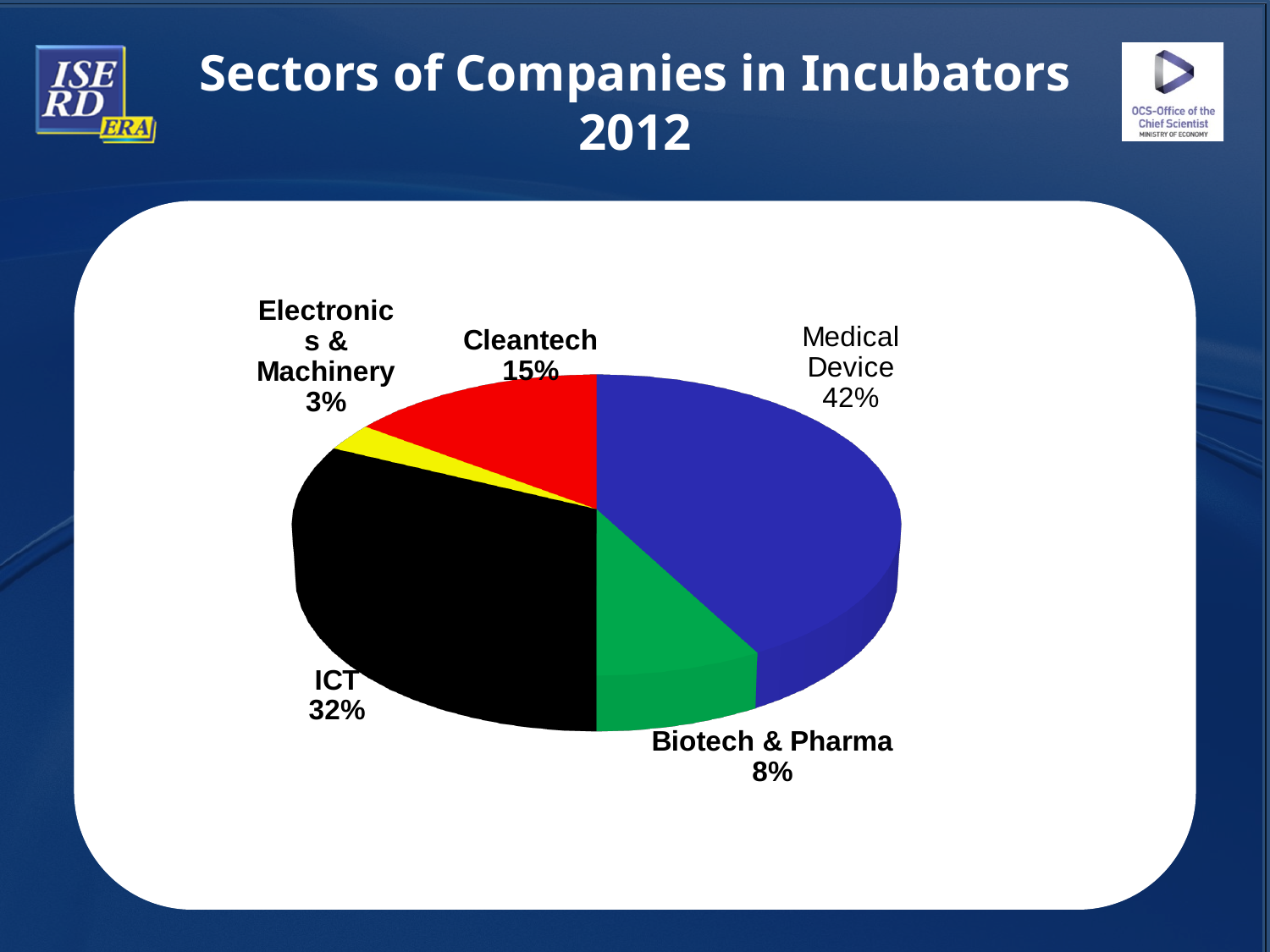
What share of companies in incubators is in the Medical Device sector? 42% How many sectors are shown in the pie chart? 5 What is the value shown for Cleantech? 15% Which sector has the smallest share? Electronics & Machinery How many percentage points larger is Medical Device than ICT? 10 What colour is the ICT slice? Black What percentage of the pie is ICT? 32% What type of chart is shown on the slide? Pie chart Which sector has the largest share of companies in incubators? Medical Device What percentage is shown for Electronics & Machinery? 3% Which is larger, Cleantech or Biotech & Pharma? Cleantech What share does Biotech & Pharma hold? 8%